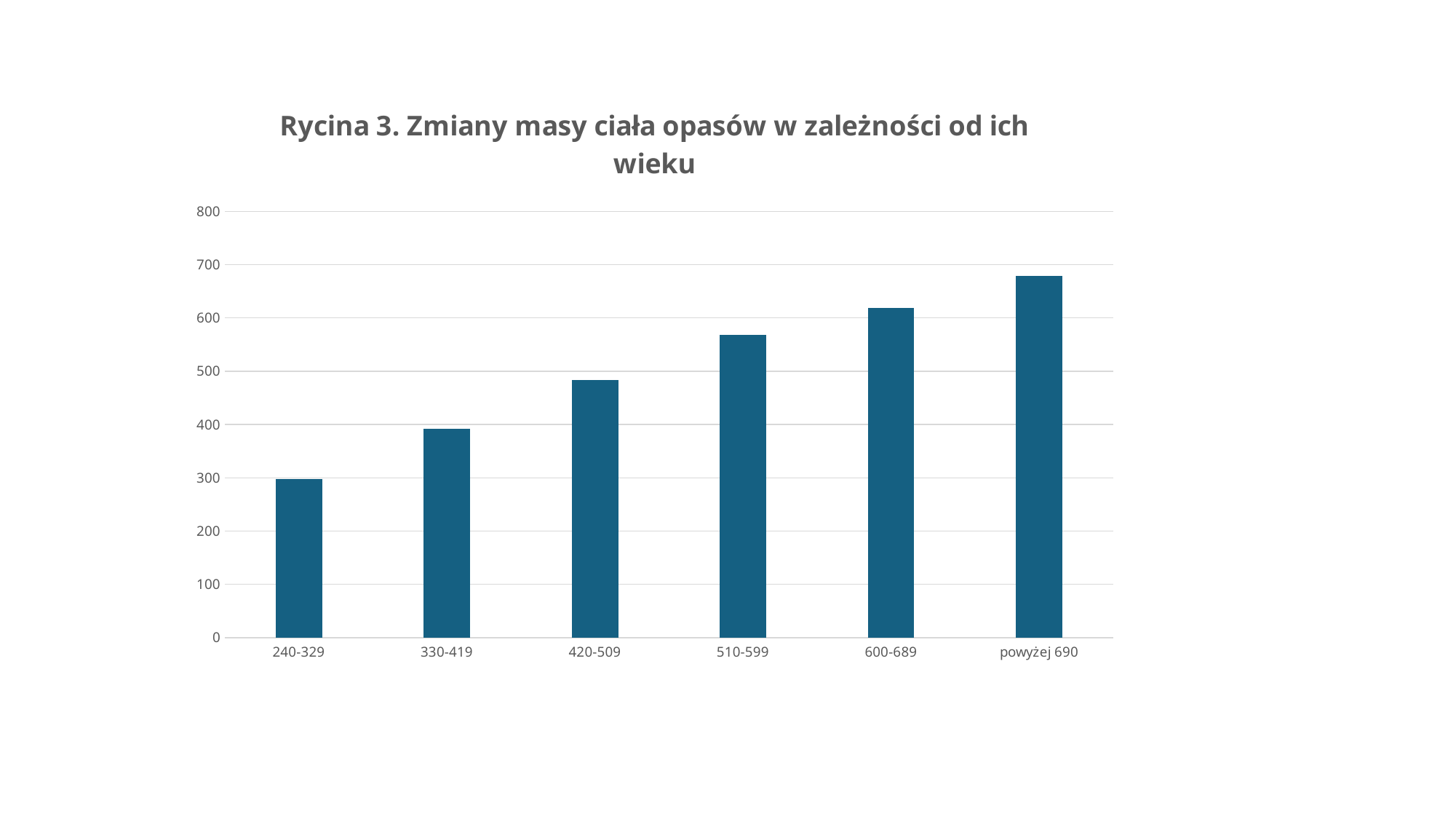
Which is larger, the value for 600-689 or the value for 420-509? 600-689 How many age categories are shown on the x axis? 6 Is the value for 240-329 greater or less than 200? greater Which category has the highest value? powyżej 690 Is the value for powyżej 690 greater or less than 700? less Is the value for 420-509 greater or less than 500? less What is the title of the chart? Rycina 3. Zmiany masy ciała opasów w zależności od ich wieku Do the values rise or fall from left to right along the x axis? rise What kind of chart is shown on the slide? bar chart Which category has the lowest value? 240-329